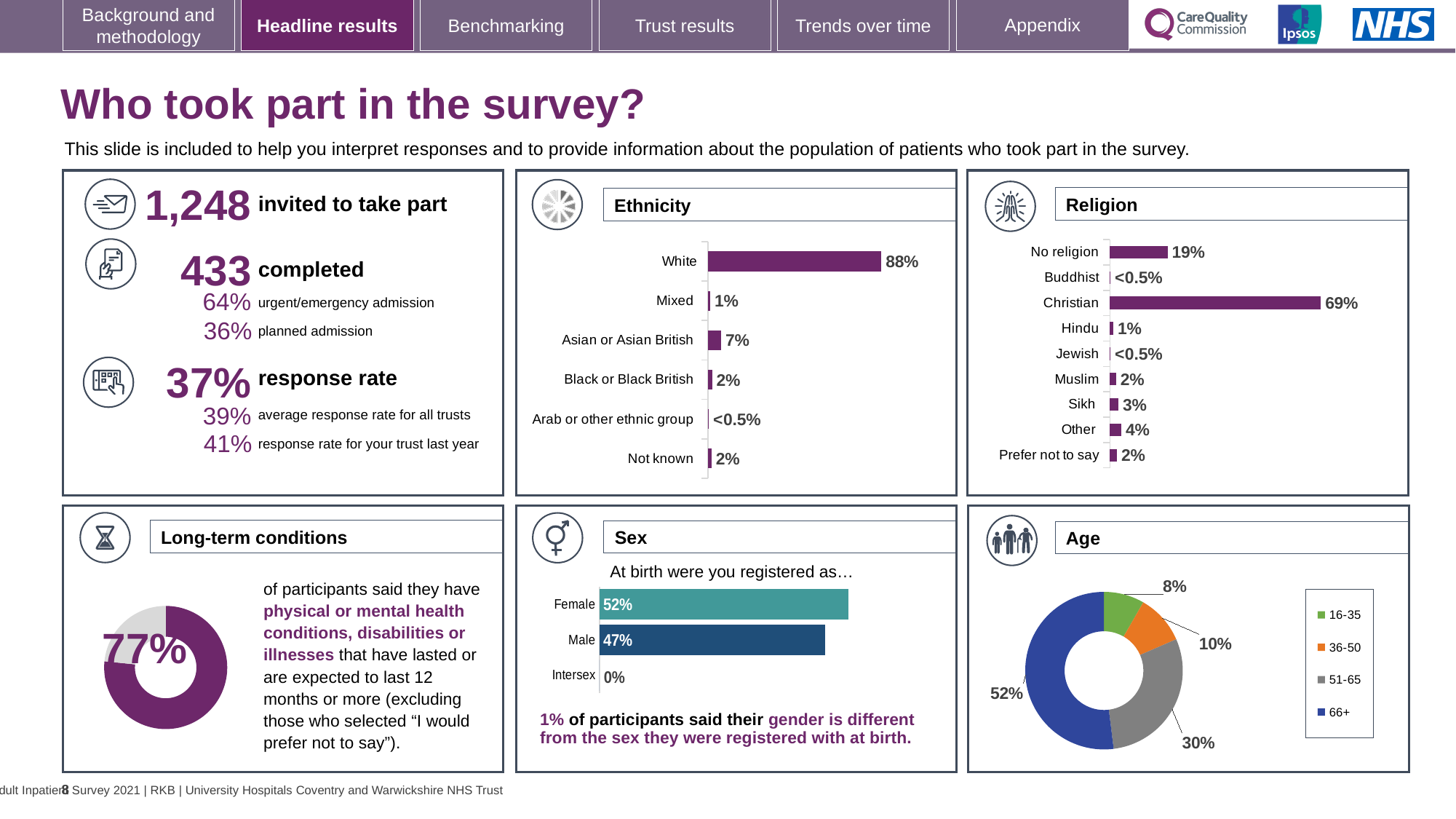
In the Ethnicity chart, which category has the highest value? White In the Religion chart, what is the difference between the Christian and No religion values? 50% In the Sex chart, what percentage of participants were registered as Female at birth? 52% In the Sex chart, what is the difference between the Female and Male values? 5% In the Ethnicity chart, what percentage of participants were White? 88% How many categories are shown in the Religion chart? 9 In the Religion chart, which is larger, Sikh or Muslim? Sikh In the Ethnicity chart, what is the value for Asian or Asian British? 7% In the Religion chart, what percentage of participants were Christian? 69% How many age groups does the legend of the Age chart list? 4 In the Age chart, what share of participants were aged 66+? 52% How many categories are shown in the Ethnicity chart? 6